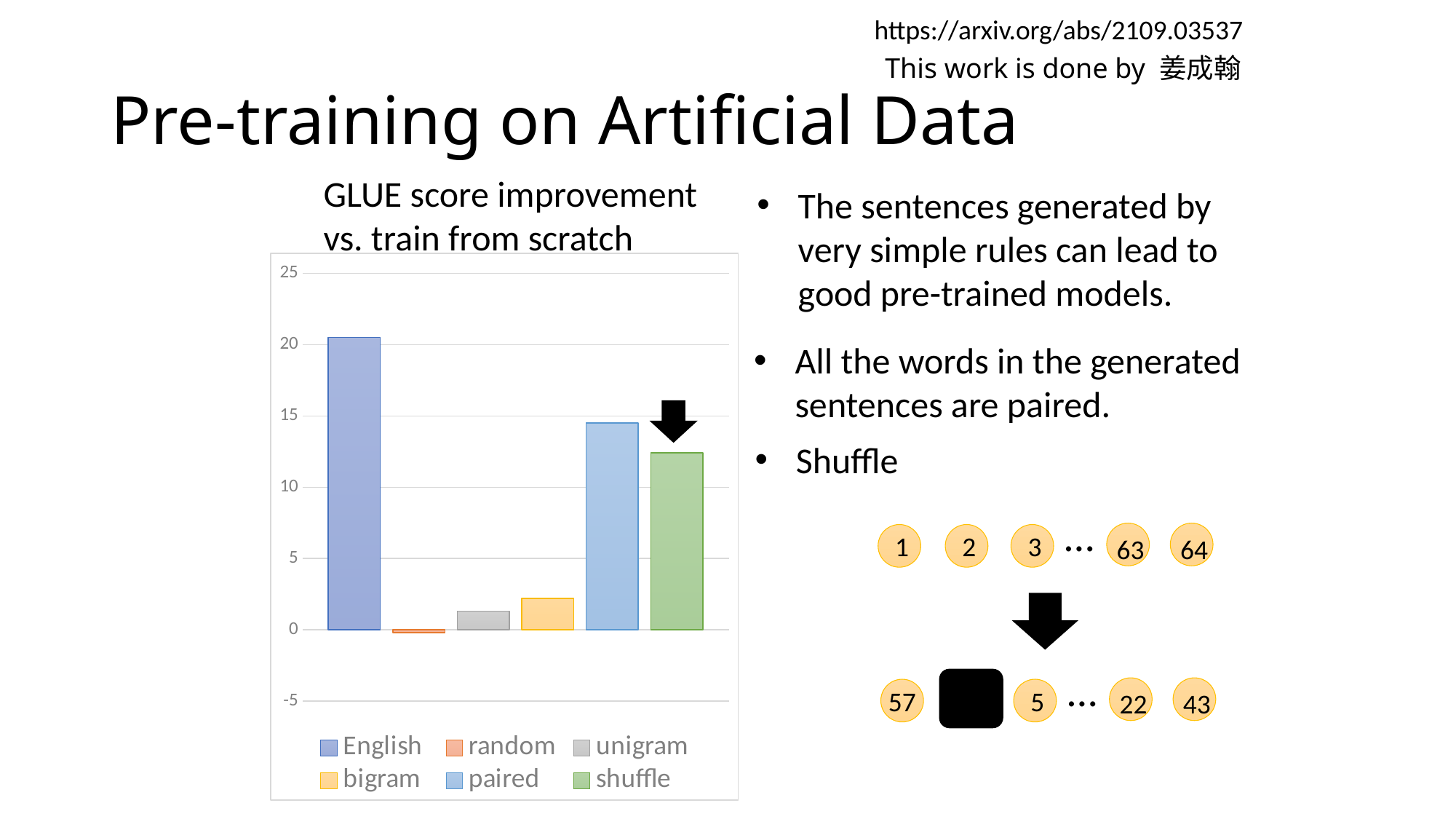
How many bars are plotted in the chart? 6 Which has a larger GLUE score improvement, paired or shuffle? paired Is the value for paired greater or less than 15? less How many series does the chart legend list? 6 Which series has the lowest GLUE score improvement? random Which has a larger GLUE score improvement, bigram or unigram? bigram Is the value for shuffle greater or less than 10? greater What kind of chart is shown on the slide? bar chart Is the value for English greater or less than 20? greater Which series has the highest GLUE score improvement? English What is the title of the chart? GLUE score improvement vs. train from scratch